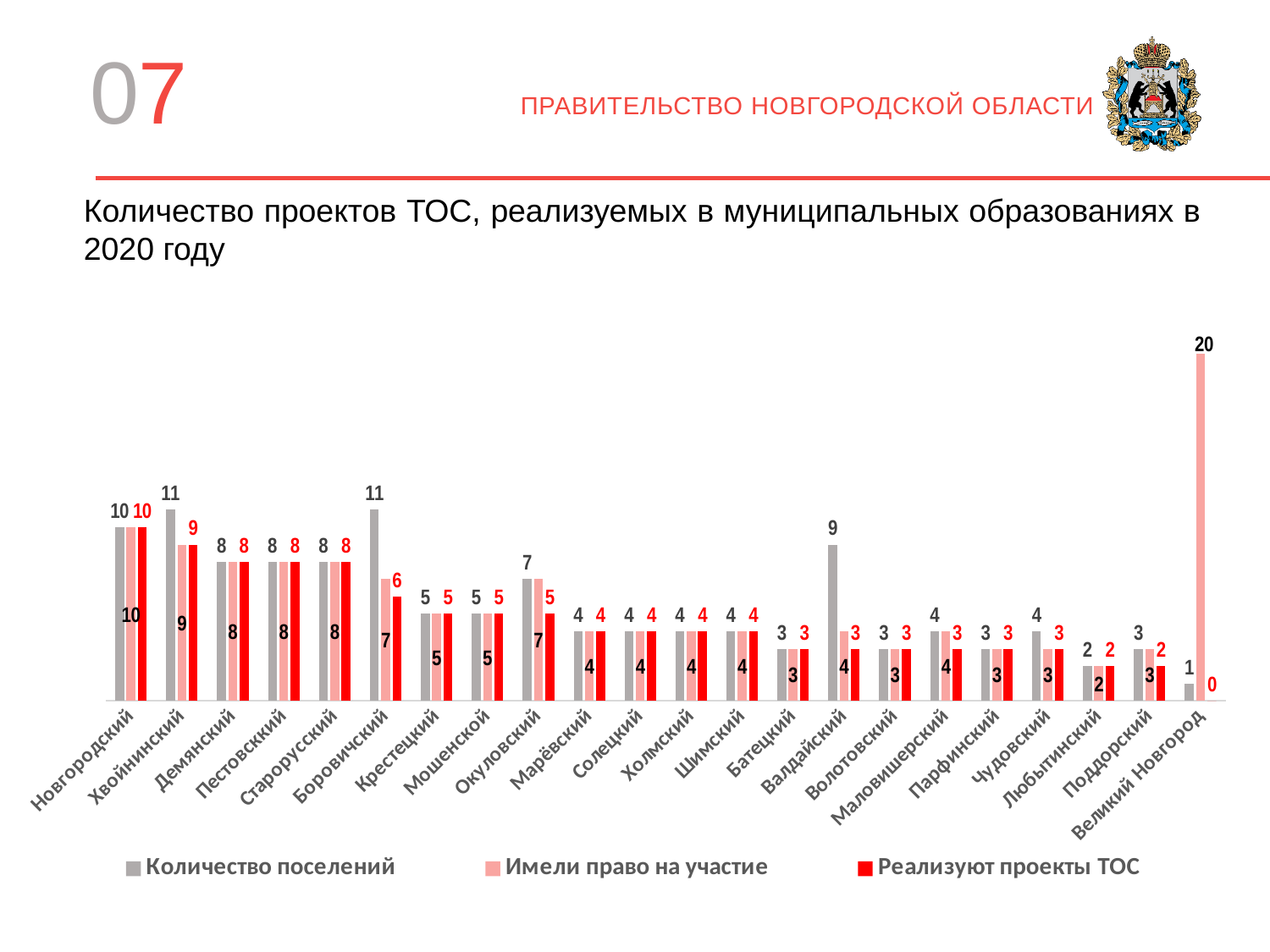
How many series does the legend list? 3 What type of chart is shown on the slide? bar chart What is the value of 'Имели право на участие' for Великий Новгород? 20 Which is larger for Хвойнинский: 'Количество поселений' or 'Реализуют проекты ТОС'? Количество поселений What is the value of 'Количество поселений' for Валдайский? 9 How many municipalities (categories) are shown on the x axis? 22 What is the title of the chart? Количество проектов ТОС, реализуемых в муниципальных образованиях в 2020 году What is the value of 'Реализуют проекты ТОС' for Боровичский? 6 Which municipality has the lowest value for 'Количество поселений'? Великий Новгород What is the value of 'Реализуют проекты ТОС' for Великий Новгород? 0 Which municipality has the highest value for 'Имели право на участие'? Великий Новгород What is the difference between 'Количество поселений' and 'Реализуют проекты ТОС' for Валдайский? 6